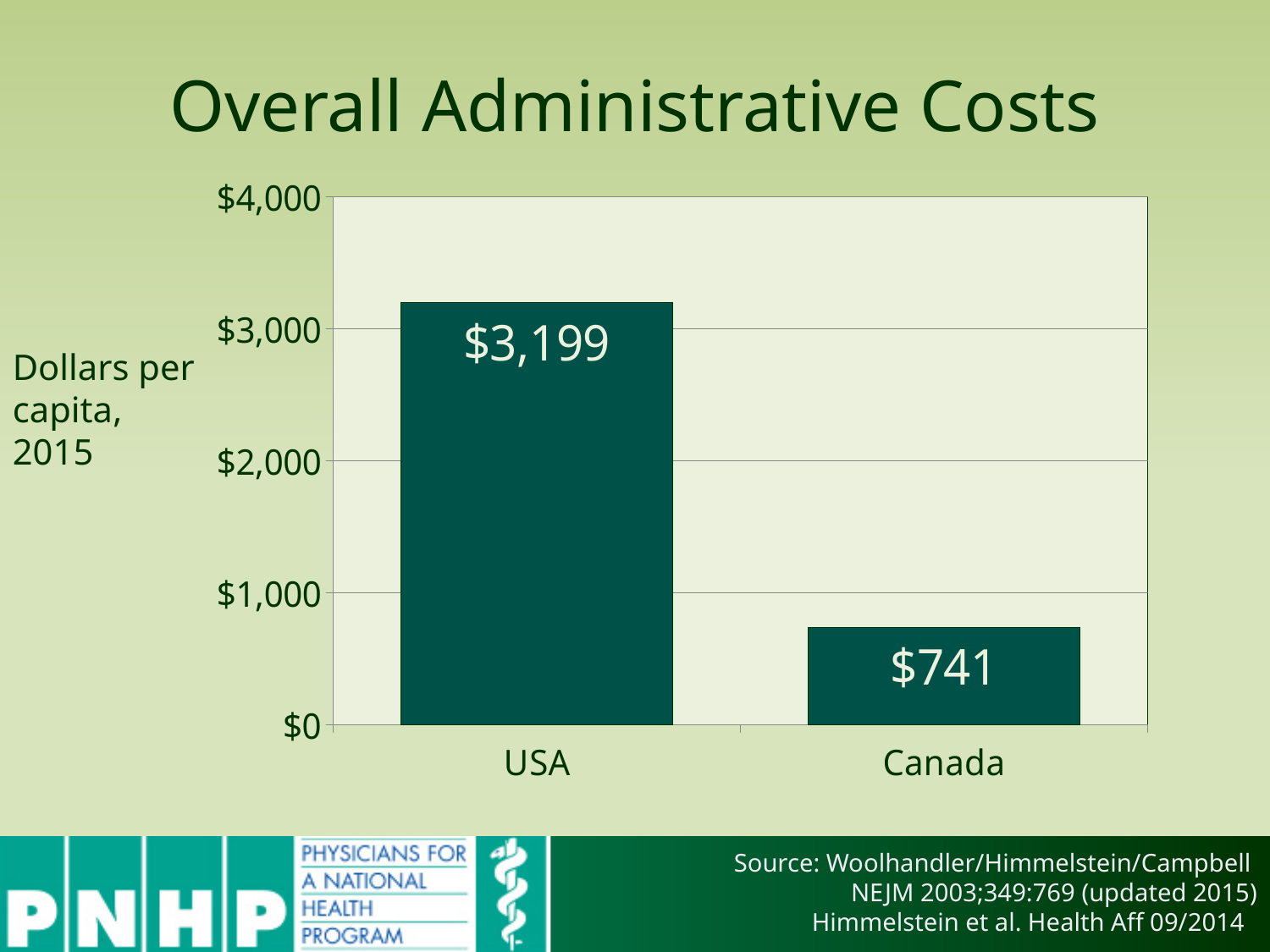
Which category has the highest value? USA What kind of chart is shown on the slide? bar chart Which category has the lowest value? Canada Which is larger, the value for USA or the value for Canada? USA What is the value for Canada? $741 Is the value for USA greater or less than $3,000? greater What is the value for USA? $3,199 How many categories are shown in the chart? 2 Is the value for Canada greater or less than $1,000? less What unit is given for the values in the chart? Dollars per capita, 2015 What is the difference between the values for USA and Canada? $2,458 What is the title of the chart? Overall Administrative Costs